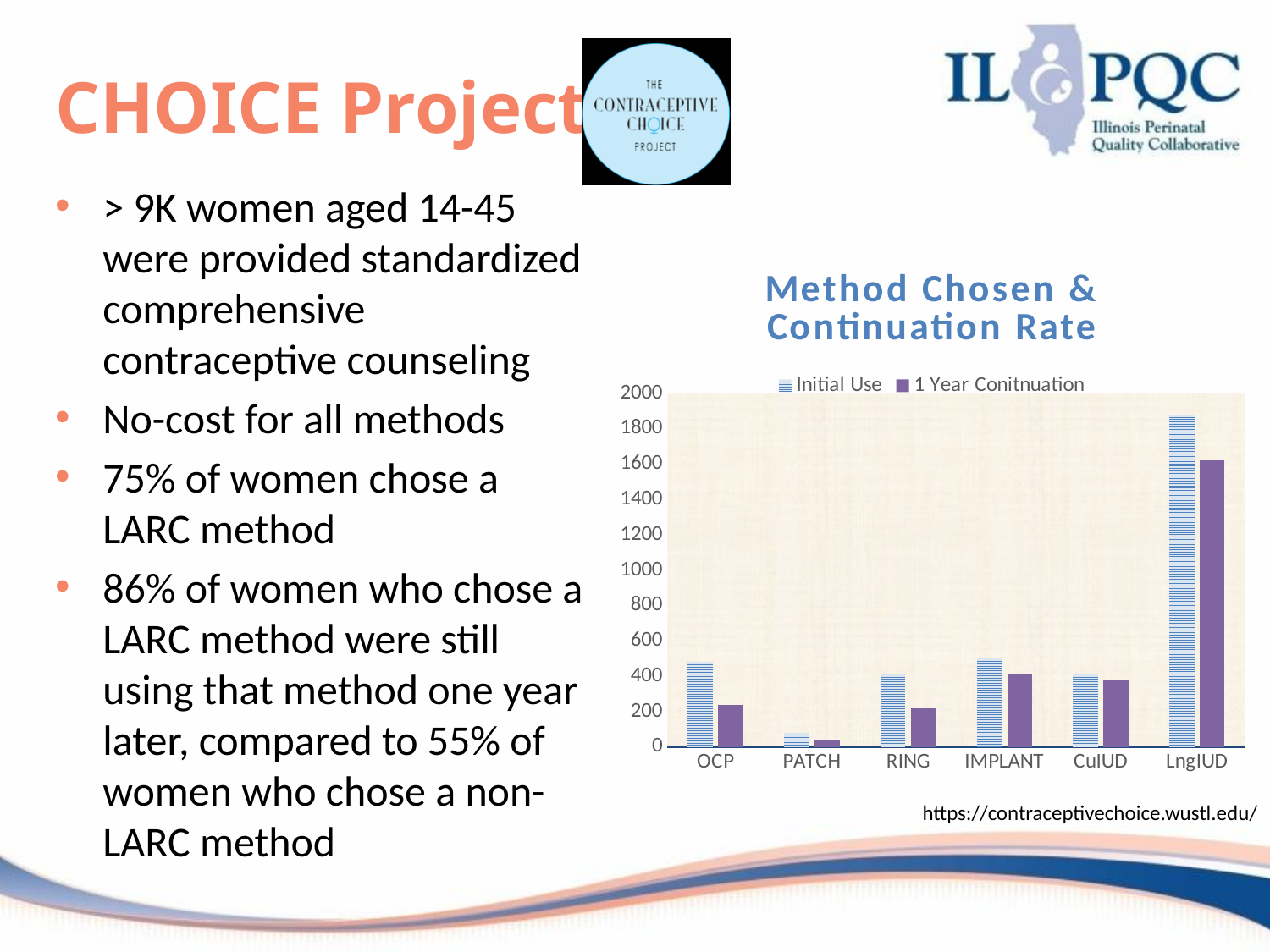
Which method has the lowest Initial Use value? PATCH What is the title of the chart? Method Chosen & Continuation Rate Which method has the highest Initial Use value? LngIUD Is the Initial Use value for PATCH greater or less than 200? less What kind of chart is shown on the slide? bar chart Which method has a larger Initial Use value, LngIUD or IMPLANT? LngIUD How many series does the chart's legend list? 2 How many contraceptive methods are shown on the x axis of the chart? 6 Is the 1 Year Conitnuation value for LngIUD greater or less than 1400? greater Which is larger for OCP: the Initial Use value or the 1 Year Conitnuation value? Initial Use Is the Initial Use value for LngIUD greater or less than 1600? greater Which method has the lowest 1 Year Conitnuation value? PATCH